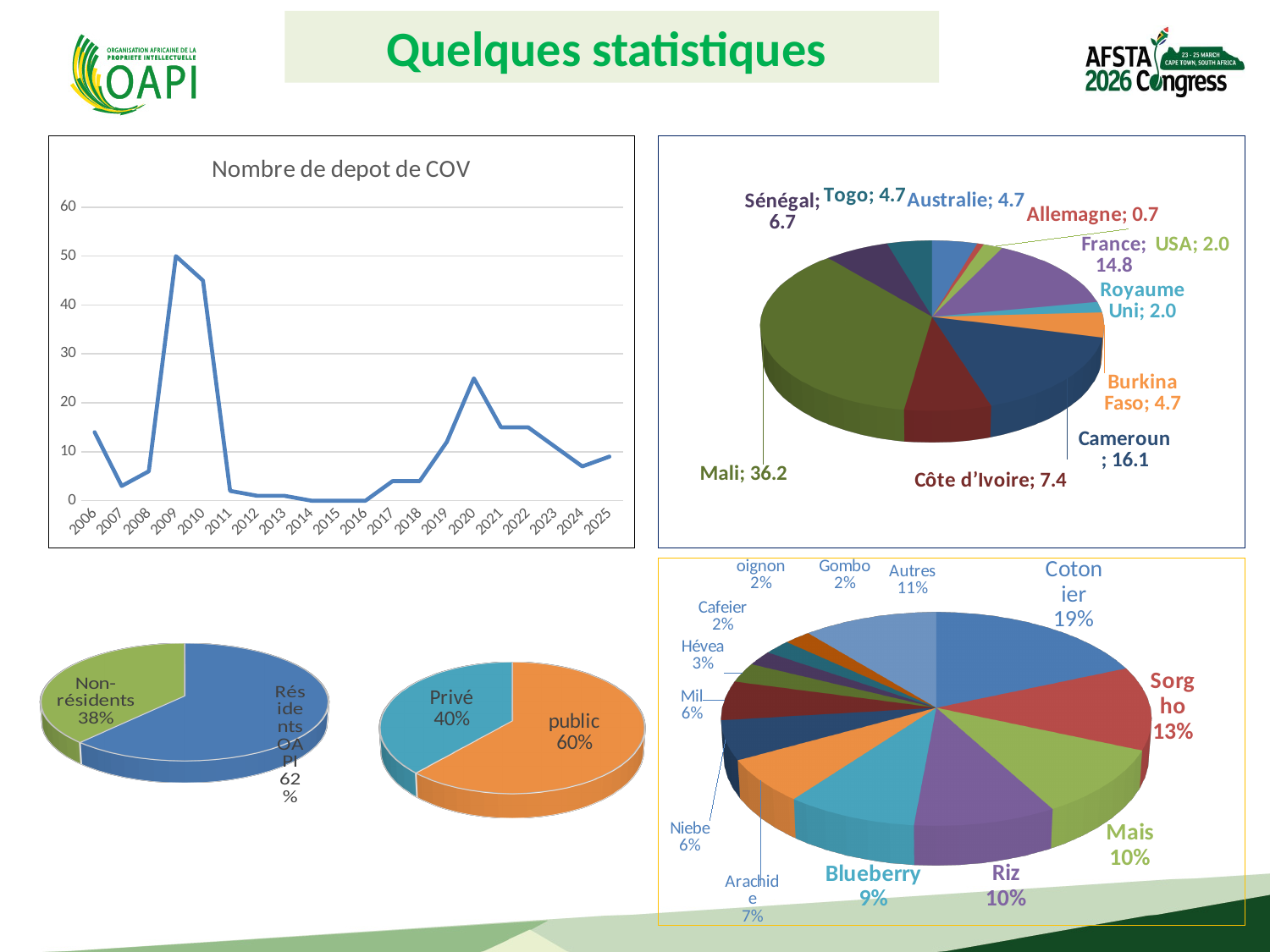
In the top-right pie chart of countries, which country has the largest value? Mali In the top-right pie chart of countries, what is the value for Cameroun? 16.1 In the 'Nombre de depot de COV' chart, is the value for 2015 greater or less than 10? less In the bottom-right pie chart of crops, which crop has the largest share? Cotonier In the 'Nombre de depot de COV' chart, do the values rise or fall from 2009 to 2011? fall In the 'Nombre de depot de COV' chart, is the value for 2009 greater or less than 40? greater In the bottom-left pie chart, what share is labelled Non-résidents? 38% In the top-right pie chart of countries, what is the difference between the values for Mali and Cameroun? 20.1 In the top-right pie chart of countries, which country has the smallest value? Allemagne What kind of chart is 'Nombre de depot de COV'? line chart In the 'Nombre de depot de COV' line chart, which year has the highest value? 2009 How many years are plotted on the x axis of the 'Nombre de depot de COV' chart? 20